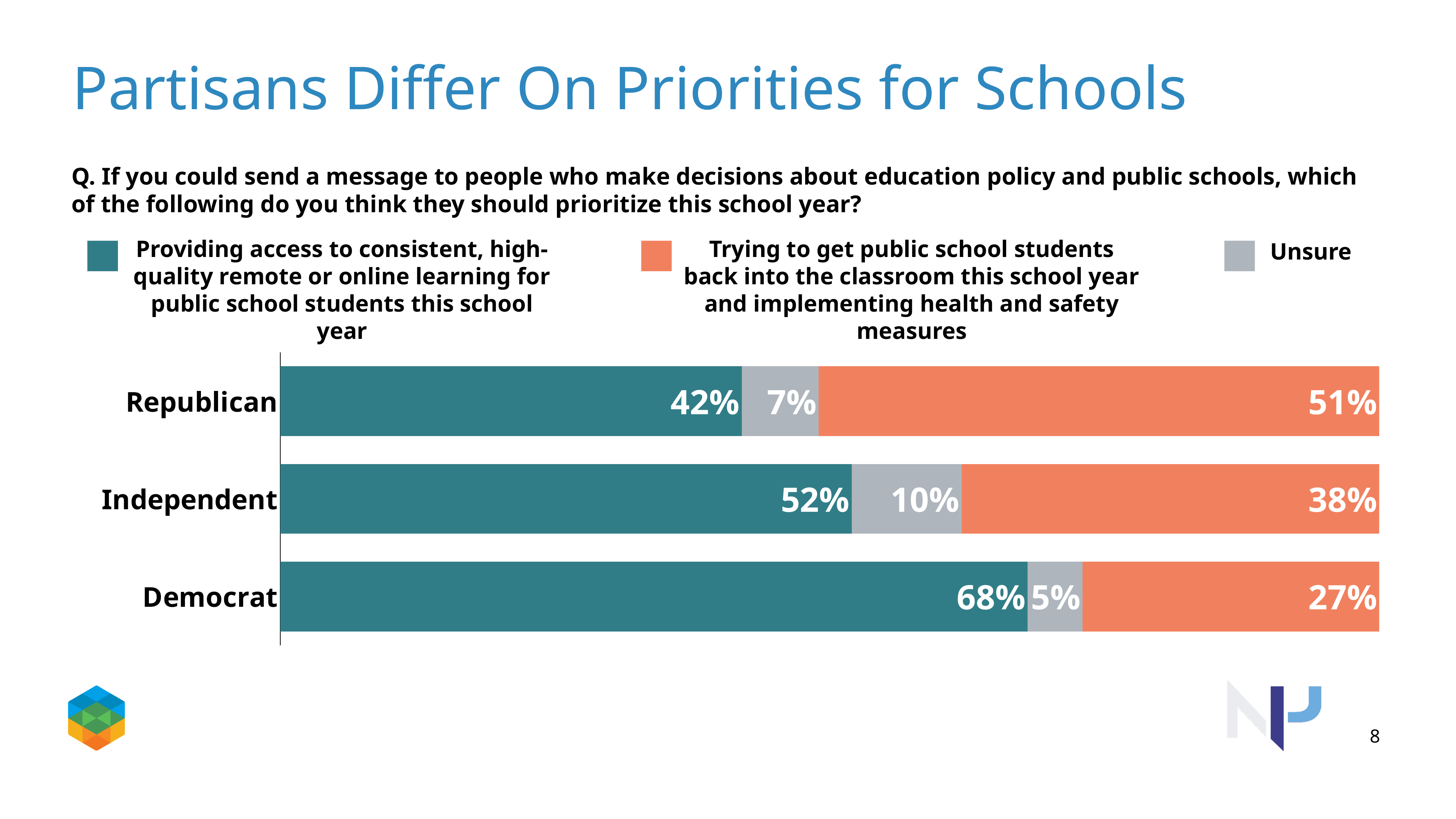
Which party group has the highest percentage choosing remote or online learning? Democrat What percentage of Republicans chose providing access to consistent, high-quality remote or online learning? 42% Which party group has the lowest percentage choosing getting students back into the classroom? Democrat What kind of chart is shown on the slide? Stacked bar chart What percentage of Independents were unsure? 10% What is the difference between the Democrat and Republican percentages for remote or online learning? 26 percentage points What percentage of Democrats chose trying to get public school students back into the classroom and implementing health and safety measures? 27% What is the total of the Independent bar? 100% Which is larger: the Republican percentage for getting students back into the classroom or the Independent percentage for the same option? Republican How many series does the legend list? 3 How many party groups are shown in the chart? 3 What colour represents the Unsure series? Grey